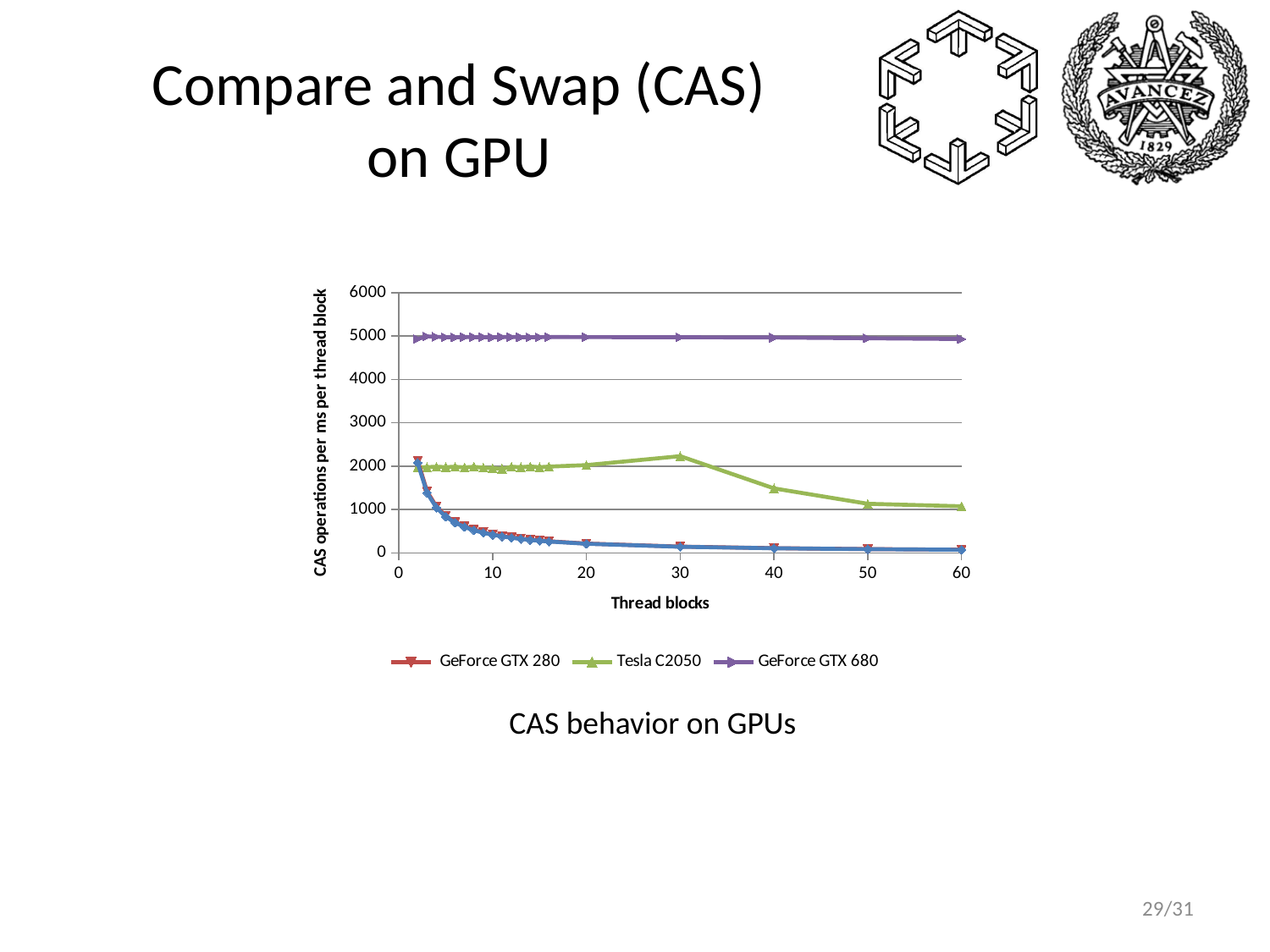
Is the value for GeForce GTX 680 at 60 thread blocks greater or less than 4000? greater How many series does the legend list? 3 Is the value for GeForce GTX 280 at 60 thread blocks greater or less than 1000? less At 30 thread blocks, which is larger: Tesla C2050 or GeForce GTX 280? Tesla C2050 Which series has the highest CAS operations per ms per thread block across the chart? GeForce GTX 680 What is the label of the x axis? Thread blocks Is the value for Tesla C2050 at 40 thread blocks greater or less than 1000? greater Which series are listed in the legend? GeForce GTX 280, Tesla C2050, GeForce GTX 680 Do the values for GeForce GTX 280 rise or fall as the number of thread blocks increases? fall What kind of chart is shown on the slide? line chart